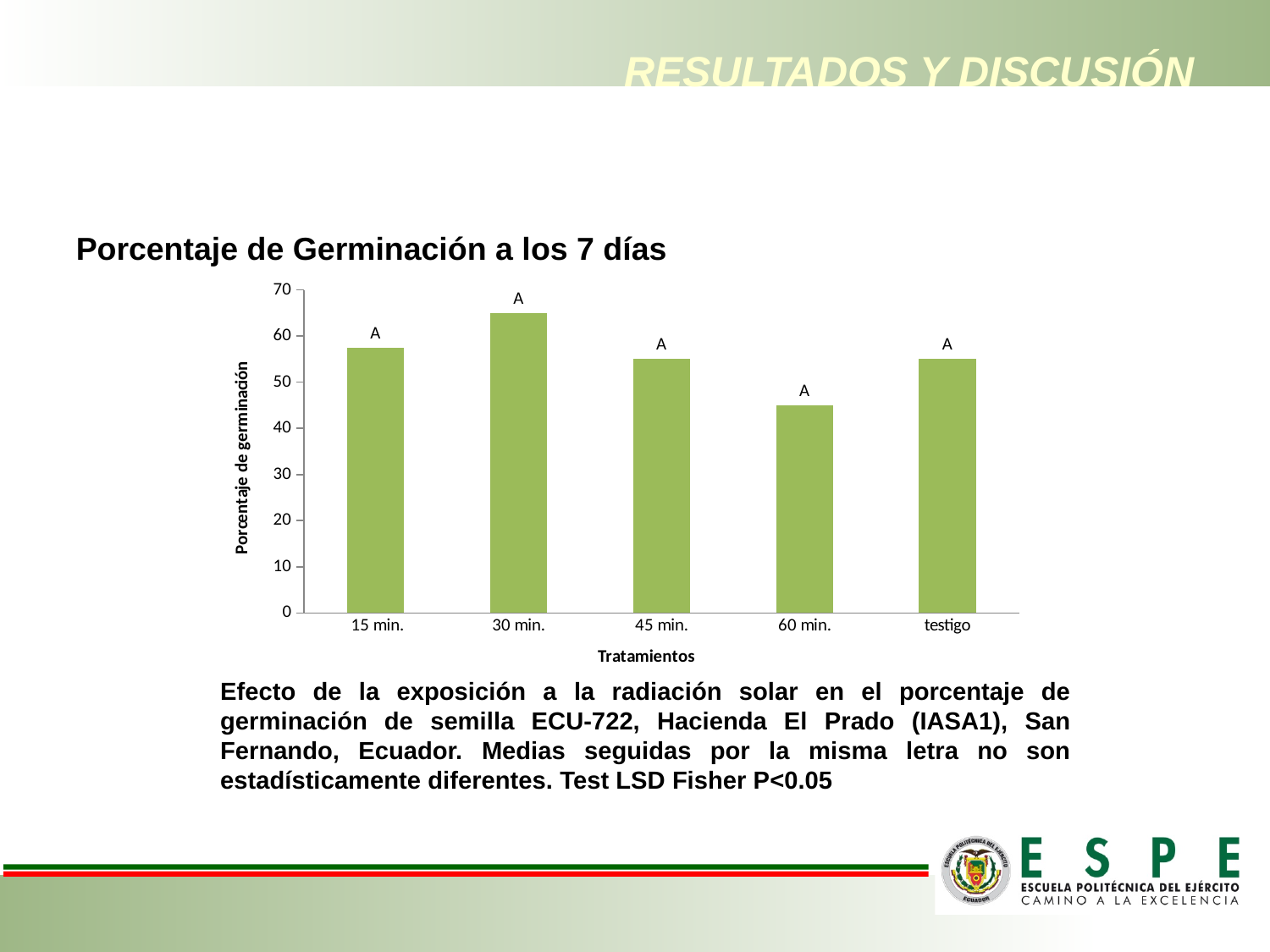
What is the title of the chart? Porcentaje de Germinación a los 7 días Which treatment has the highest germination percentage? 30 min. Is the value for 30 min. greater or less than 60? greater Which treatment has the lowest germination percentage? 60 min. Is the value for 60 min. greater or less than 50? less Which is larger, the value for 30 min. or the value for testigo? 30 min. Is the value for testigo greater or less than 60? less How many treatments (categories) are shown on the x axis of the chart? 5 What is the label of the x axis of the chart? Tratamientos What type of chart is shown on the slide? bar chart Which is larger, the value for 15 min. or the value for 60 min.? 15 min.